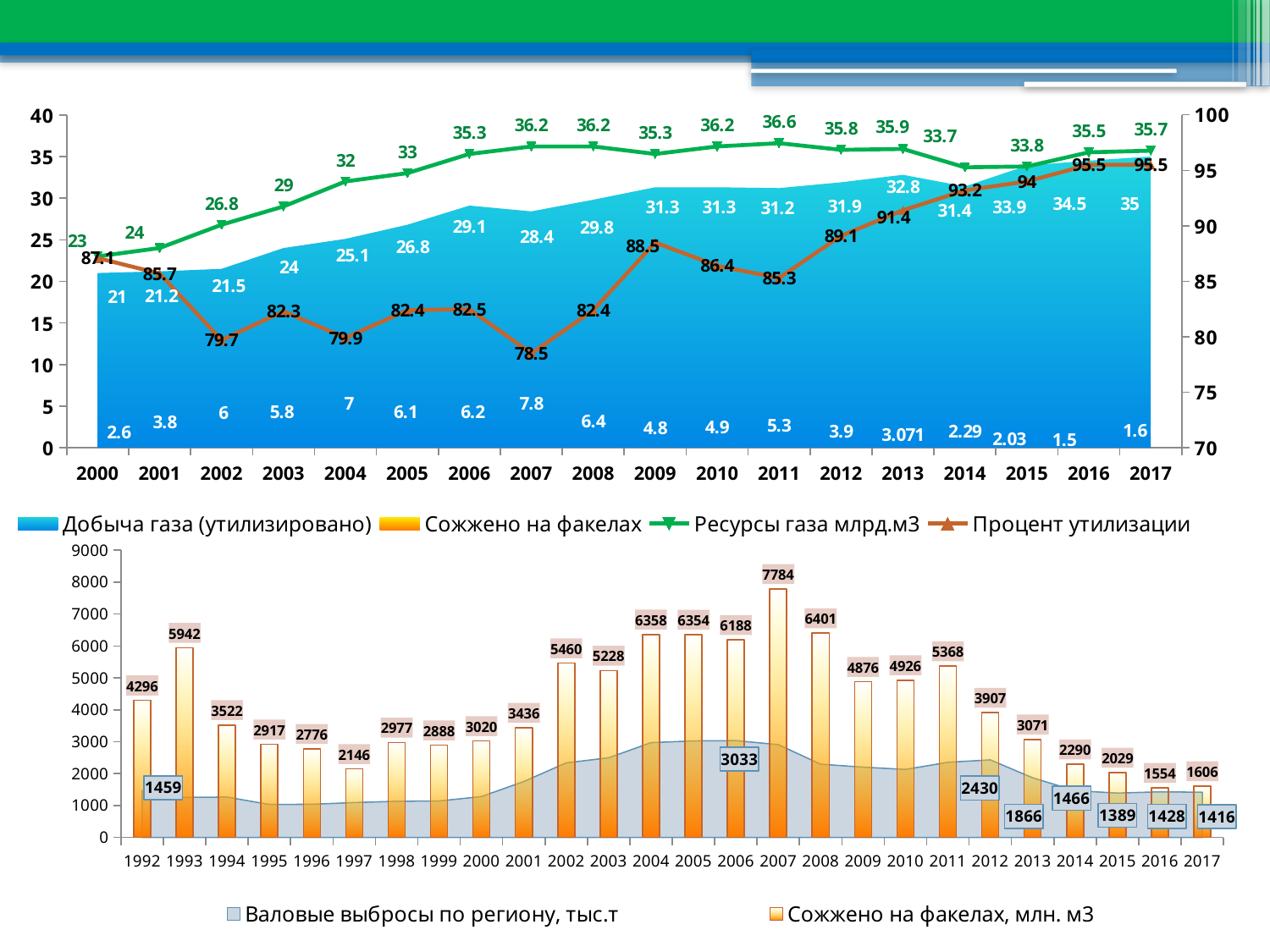
How many years are shown on the x axis of the bottom chart? 26 In the bottom chart, is the Валовые выбросы по региону value for 2000 greater or less than 2000? less In the top chart, which year has the lowest Процент утилизации value? 2007 In the top chart, what is the Сожжено на факелах value for 2013? 3.071 How many series does the legend of the top chart list? 4 In the top chart, what is the Процент утилизации value for 2007? 78.5 In the bottom chart, which is larger: the Сожжено на факелах value for 2004 or for 2005? 2004 In the top chart, what is the difference between the Ресурсы газа values for 2017 and 2000? 12.7 In the top chart, what is the value of Ресурсы газа млрд.м3 for 2011? 36.6 In the bottom chart, which year has the highest Сожжено на факелах, млн. м3 value? 2007 In the bottom chart, what is the Валовые выбросы по региону, тыс.т value for 2006? 3033 In the bottom chart, what is the Сожжено на факелах, млн. м3 value for 1993? 5942